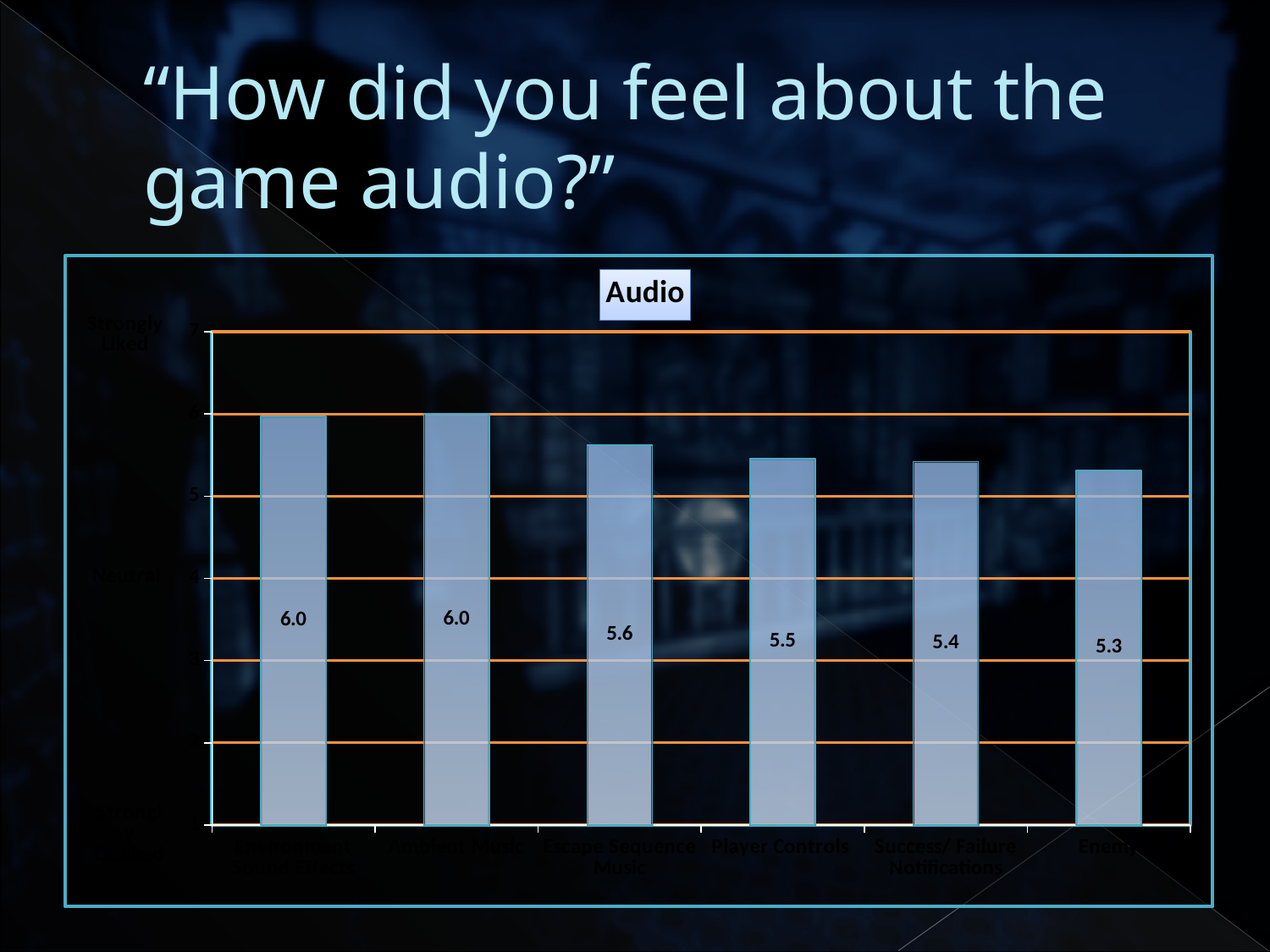
How many bars are plotted in the chart? 6 What kind of chart is shown on the slide? bar chart What is the value for Escape Sequence Music? 5.6 Do the values rise or fall from left to right across the chart? fall Which is larger, the value for Escape Sequence Music or the value for Success/ Failure Notifications? Escape Sequence Music What is the value for Player Controls? 5.5 Which category has the lowest value? Enemy Is the value for Player Controls greater or less than 5? greater What is the difference between the values for Ambient Music and Enemy? 0.7 What is the value for Enemy? 5.3 What is the title of the chart? Audio What is the value for Ambient Music? 6.0